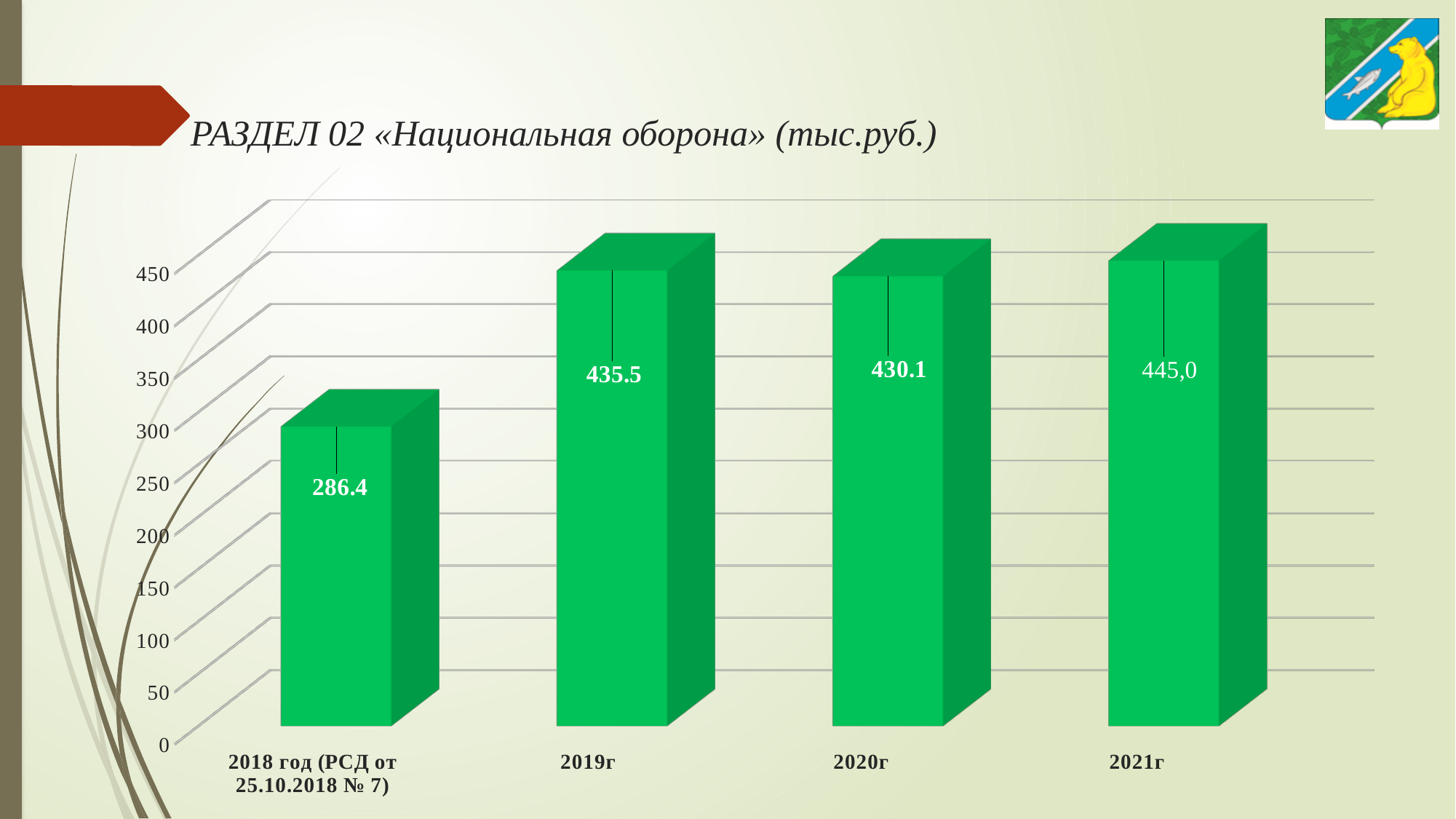
What is the difference between the values for 2019г and 2018 год (РСД от 25.10.2018 № 7)? 149.1 Which year has the highest value? 2021г What is the value for 2018 год (РСД от 25.10.2018 № 7)? 286.4 What is the value for 2019г? 435.5 What is the title of the chart? РАЗДЕЛ 02 «Национальная оборона» (тыс.руб.) How many bars are shown in the chart? 4 What is the value for 2021г? 445,0 Is the value for 2018 год (РСД от 25.10.2018 № 7) greater or less than 300? less What kind of chart is shown on the slide? bar chart What is the value for 2020г? 430.1 Which is larger, the value for 2019г or the value for 2020г? 2019г Which category has the lowest value? 2018 год (РСД от 25.10.2018 № 7)